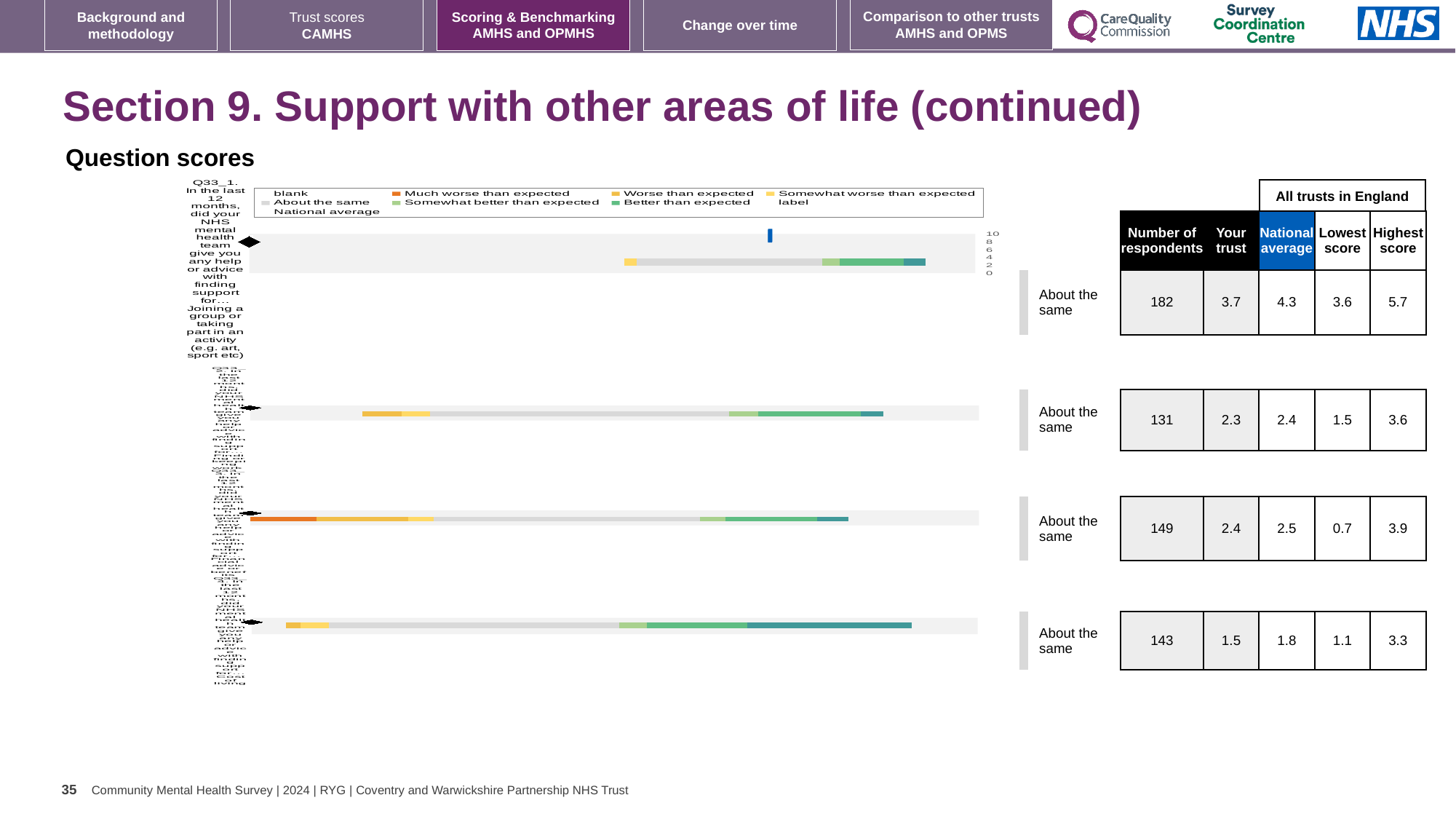
For the first chart (Q33_1, help finding support for joining a group or taking part in an activity), what is the number of respondents shown in the table? 182 For the first chart (Q33_1, joining a group or taking part in an activity), what is the "Your trust" score? 3.7 In the chart legend, what colour represents "Much worse than expected"? orange What kind of chart is used to show the question scores on this slide? bar chart For the first chart (Q33_1, joining a group or taking part in an activity), is the "Your trust" score higher or lower than the national average? lower How many bar charts are shown on the slide? 4 For the first chart (Q33_1, joining a group or taking part in an activity), what is the lowest score among all trusts in England? 3.6 For the first chart (Q33_1, joining a group or taking part in an activity), what is the difference between the highest and lowest scores among all trusts in England? 2.1 For the first chart (Q33_1, joining a group or taking part in an activity), what is the national average score? 4.3 For the first chart (Q33_1, joining a group or taking part in an activity), what is the highest score among all trusts in England? 5.7 For the first chart (Q33_1, joining a group or taking part in an activity), what is the difference between the national average and the "Your trust" score? 0.6 What is the highest value shown on the score axis of the first chart? 10